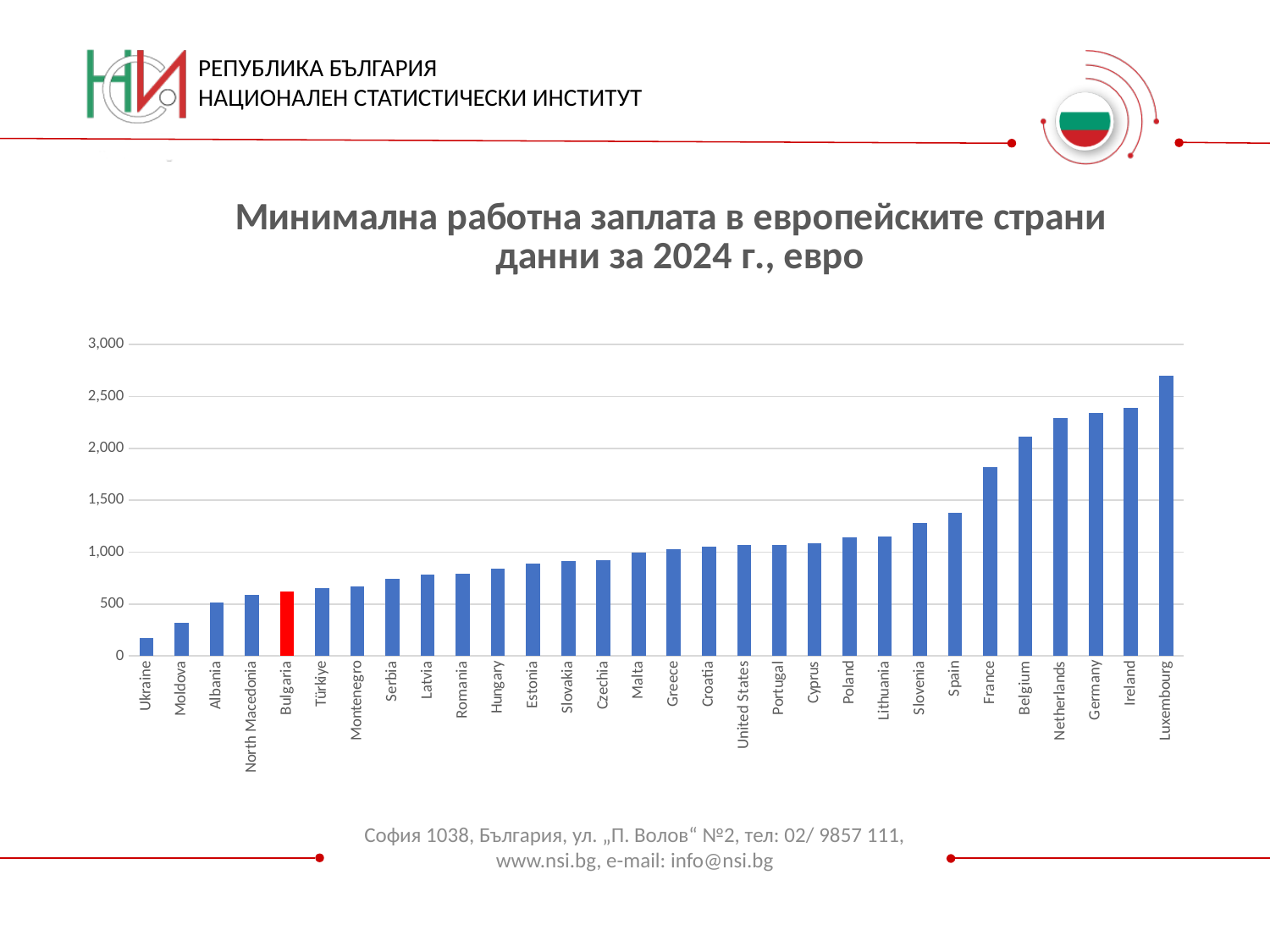
Which has a higher minimum wage, Bulgaria or Albania? Bulgaria Is the value for Hungary greater or less than 1,000? less How many countries are shown on the chart? 30 Is the value for Luxembourg greater or less than 2,500? greater What kind of chart is shown on the slide? bar chart Is the value for France greater or less than 1,500? greater Which country has the lowest minimum wage on the chart? Ukraine Which country has the highest minimum wage on the chart? Luxembourg Which country's bar is highlighted in red? Bulgaria Do the values rise or fall from left to right along the x axis? rise